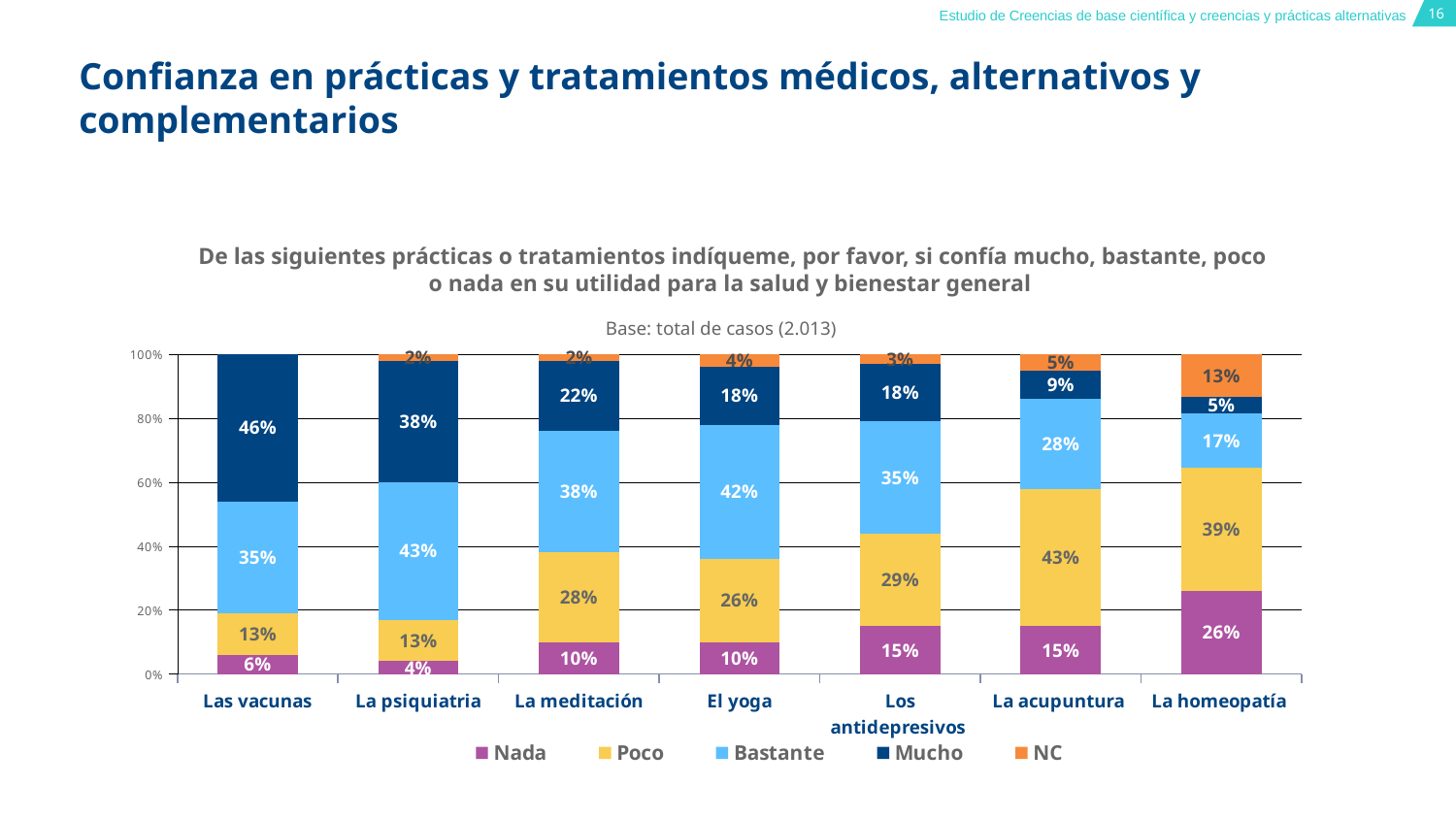
Which colour represents the 'NC' series in the legend? Orange Which category has the lowest 'Mucho' value? La homeopatía What is the 'Poco' value for La acupuntura? 43% How many practices or treatments (categories) are shown on the x axis? 7 What is the 'Bastante' value for El yoga? 42% What is the 'Nada' value for La homeopatía? 26% What kind of chart is shown on the slide? Stacked bar chart Which is larger: the 'Bastante' value for La psiquiatria or the 'Bastante' value for Los antidepresivos? La psiquiatria How many series does the legend list? 5 What is the 'Mucho' value for Las vacunas? 46% What is the difference between the 'Nada' value for La homeopatía and the 'Nada' value for Las vacunas? 20 percentage points Which category has the highest 'Mucho' value? Las vacunas